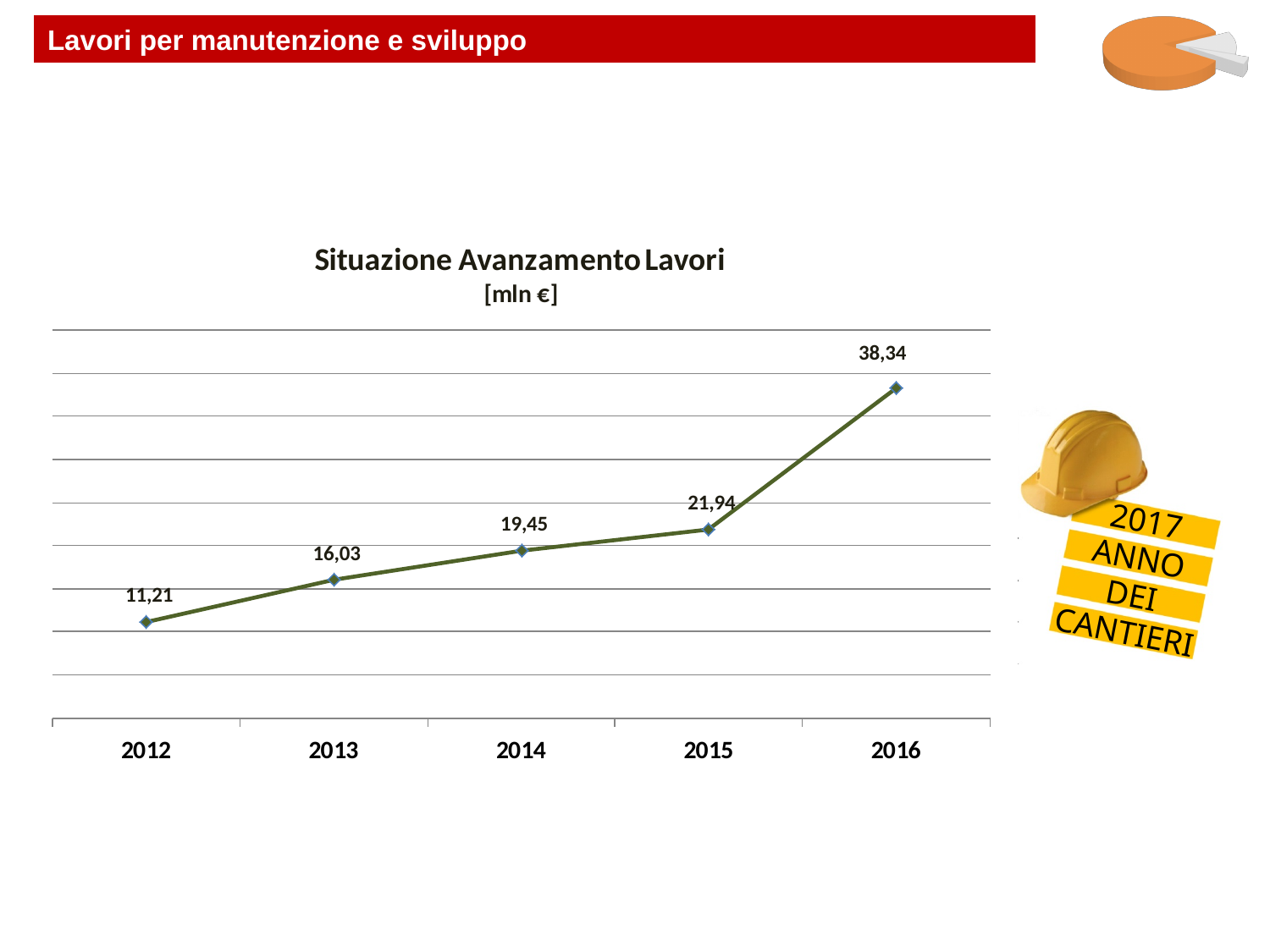
What is the difference between the values for 2016 and 2015 in the Situazione Avanzamento Lavori chart? 16,40 What is the value for 2016 in the Situazione Avanzamento Lavori chart? 38,34 How many years are plotted in the Situazione Avanzamento Lavori chart? 5 What is the value for 2012 in the Situazione Avanzamento Lavori chart? 11,21 What kind of chart is the Situazione Avanzamento Lavori chart? line chart What is the difference between the values for 2013 and 2012 in the Situazione Avanzamento Lavori chart? 4,82 Do the values in the Situazione Avanzamento Lavori chart rise or fall from 2012 to 2016? rise Which year has the highest value in the Situazione Avanzamento Lavori chart? 2016 What is the value for 2014 in the Situazione Avanzamento Lavori chart? 19,45 Which year has the lowest value in the Situazione Avanzamento Lavori chart? 2012 What unit is shown under the title of the Situazione Avanzamento Lavori chart? [mln €] Which is larger in the Situazione Avanzamento Lavori chart, the value for 2015 or the value for 2014? 2015